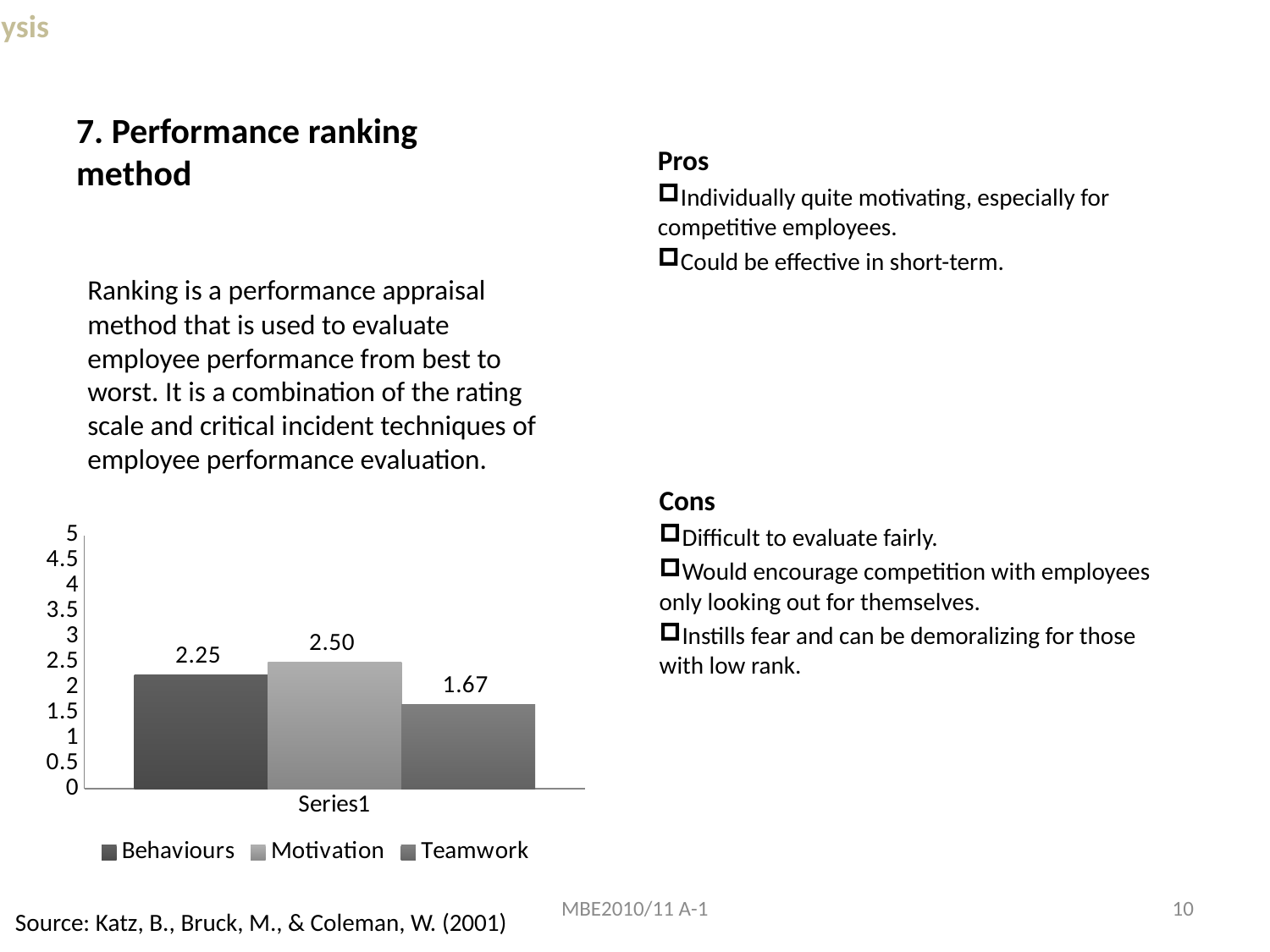
Is the value for Teamwork greater or less than 2? less What is the difference between the values for Motivation and Behaviours? 0.25 What kind of chart is shown on the slide? bar chart Which series has the highest value? Motivation Which is larger, the value for Behaviours or the value for Teamwork? Behaviours What is the value for Motivation? 2.50 What is the value for Behaviours? 2.25 What is the value for Teamwork? 1.67 Which series has the lowest value? Teamwork What is the difference between the values for Motivation and Teamwork? 0.83 What is the label on the x axis under the bars? Series1 How many series does the legend list? 3